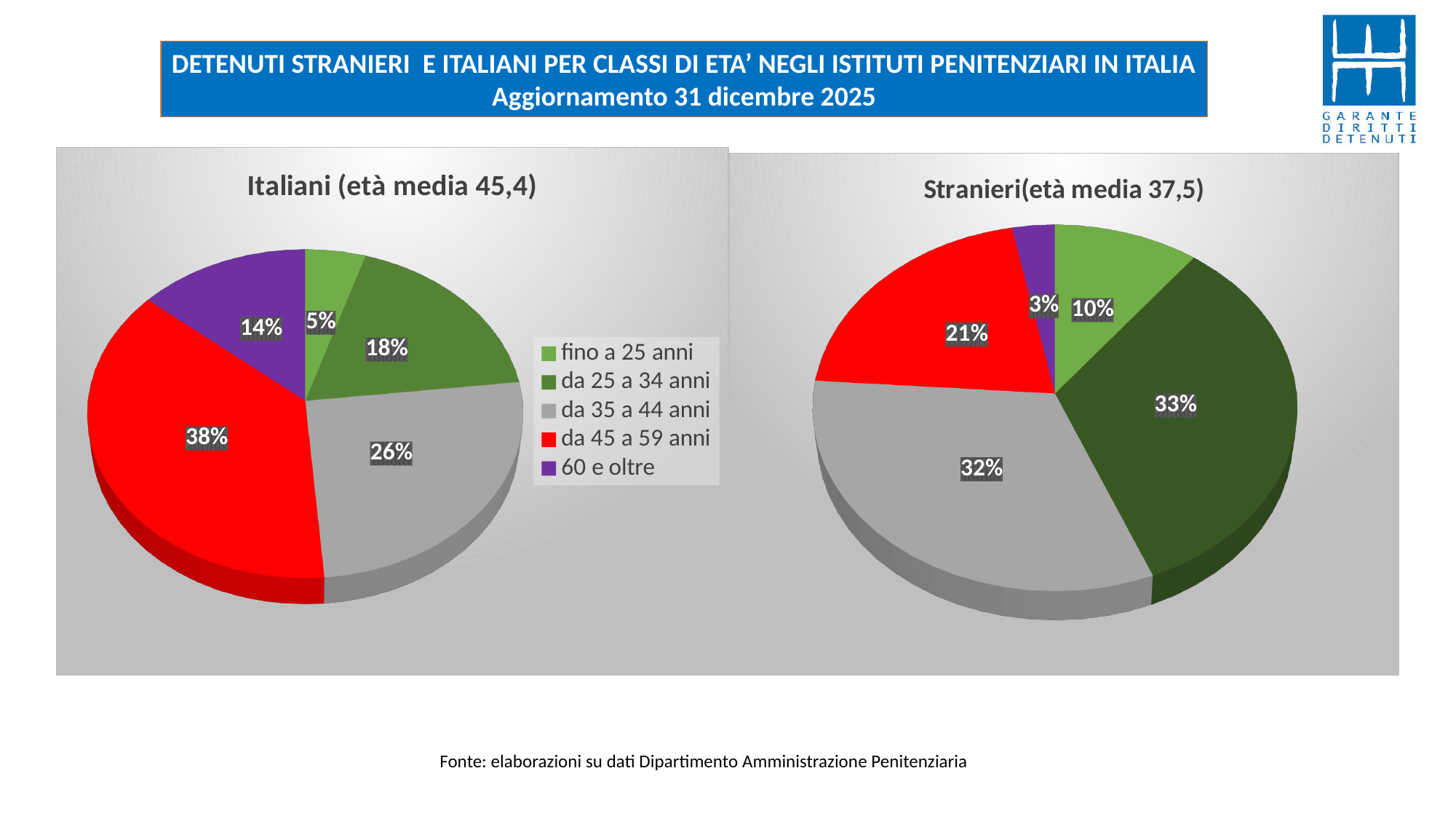
How many age classes does the legend list? 5 In the 'Italiani (età media 45,4)' chart, what share is shown for 'fino a 25 anni'? 5% Which is larger: the 'da 35 a 44 anni' share in the 'Italiani' chart or in the 'Stranieri' chart? Stranieri Which colour represents 'da 45 a 59 anni' in the legend? Red What is the difference between the 'da 45 a 59 anni' share in the 'Italiani' chart and the 'da 45 a 59 anni' share in the 'Stranieri' chart? 17 percentage points In the 'Italiani (età media 45,4)' chart, which age class has the smallest slice? fino a 25 anni In the 'Stranieri(età media 37,5)' chart, which age class has the smallest slice? 60 e oltre In the 'Italiani (età media 45,4)' chart, which age class has the largest slice? da 45 a 59 anni In the 'Italiani (età media 45,4)' chart, what share is shown for 'da 45 a 59 anni'? 38% In the 'Stranieri(età media 37,5)' chart, what share is shown for '60 e oltre'? 3% What kind of chart is used for the 'Italiani (età media 45,4)' data? Pie chart In the 'Stranieri(età media 37,5)' chart, what share is shown for 'da 25 a 34 anni'? 33%